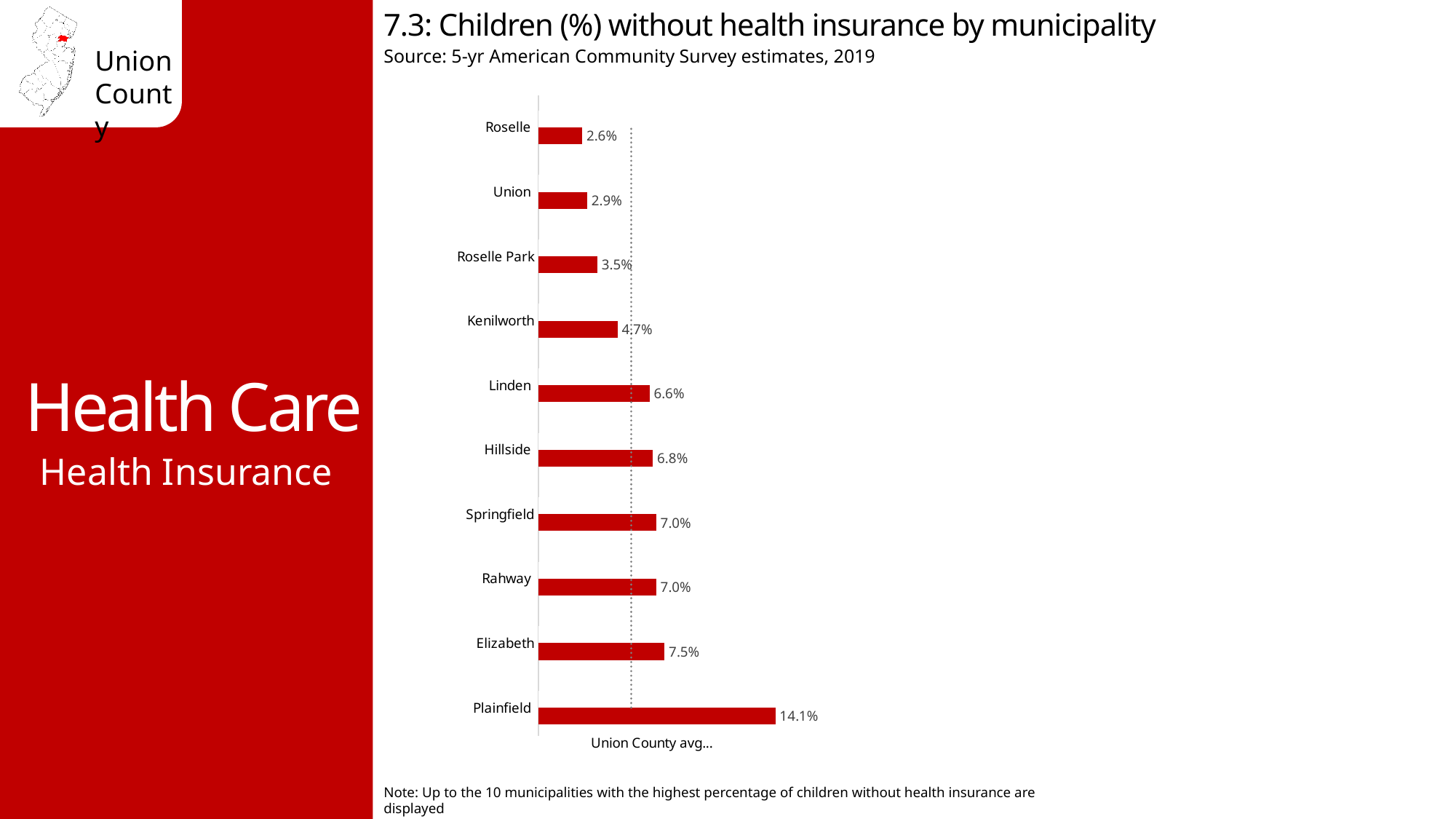
What is the value shown for Hillside? 6.8% Which municipality has the highest percentage of children without health insurance? Plainfield What percentage of children in Plainfield are without health insurance? 14.1% What kind of chart is shown on the slide? Bar chart How many municipalities are shown in the chart? 10 What does the dotted vertical line in the chart represent? Union County avg Which two municipalities share the same value of 7.0%? Springfield and Rahway What is the value shown for Kenilworth? 4.7% What is the difference between the values for Linden and Union? 3.7% Which has a higher value, Roselle Park or Springfield? Springfield Which municipality has the lowest percentage of children without health insurance? Roselle What is the difference between the values for Plainfield and Elizabeth? 6.6%